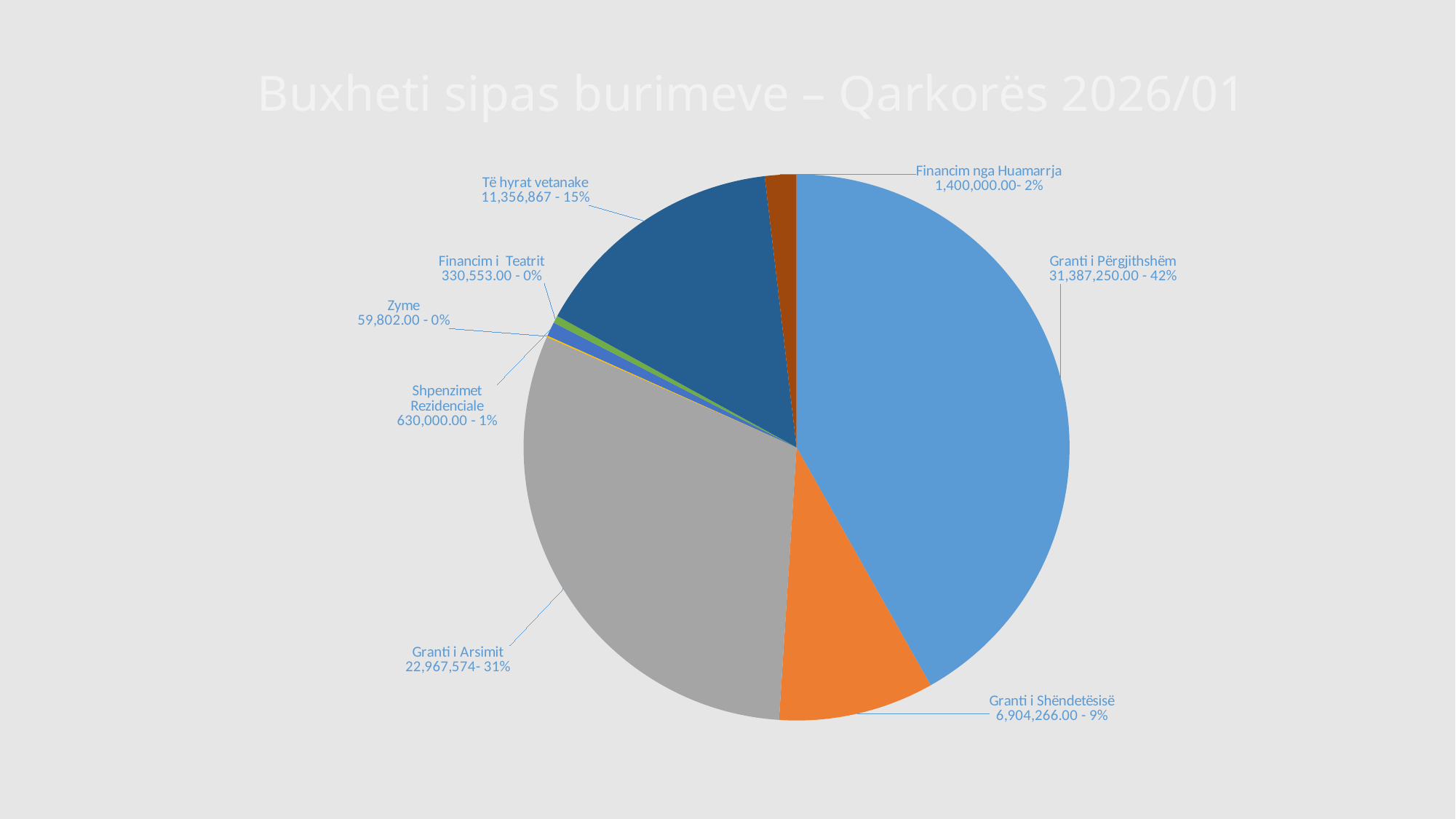
What is the value shown for Granti i Shëndetësisë? 6,904,266.00 Which is larger, Financim nga Huamarrja or Shpenzimet Rezidenciale? Financim nga Huamarrja What is the value shown for Granti i Përgjithshëm? 31,387,250.00 What percentage share does Granti i Arsimit have? 31% What percentage share does Të hyrat vetanake have? 15% How many slices does the pie chart have? 8 Which category has the largest slice of the pie? Granti i Përgjithshëm What is the value shown for Të hyrat vetanake? 11,356,867 What is the title of the chart? Buxheti sipas burimeve – Qarkorës 2026/01 Which category has the smallest value? Zyme What is the difference between the values for Financim i Teatrit and Zyme? 270,751.00 What kind of chart is shown on the slide? pie chart